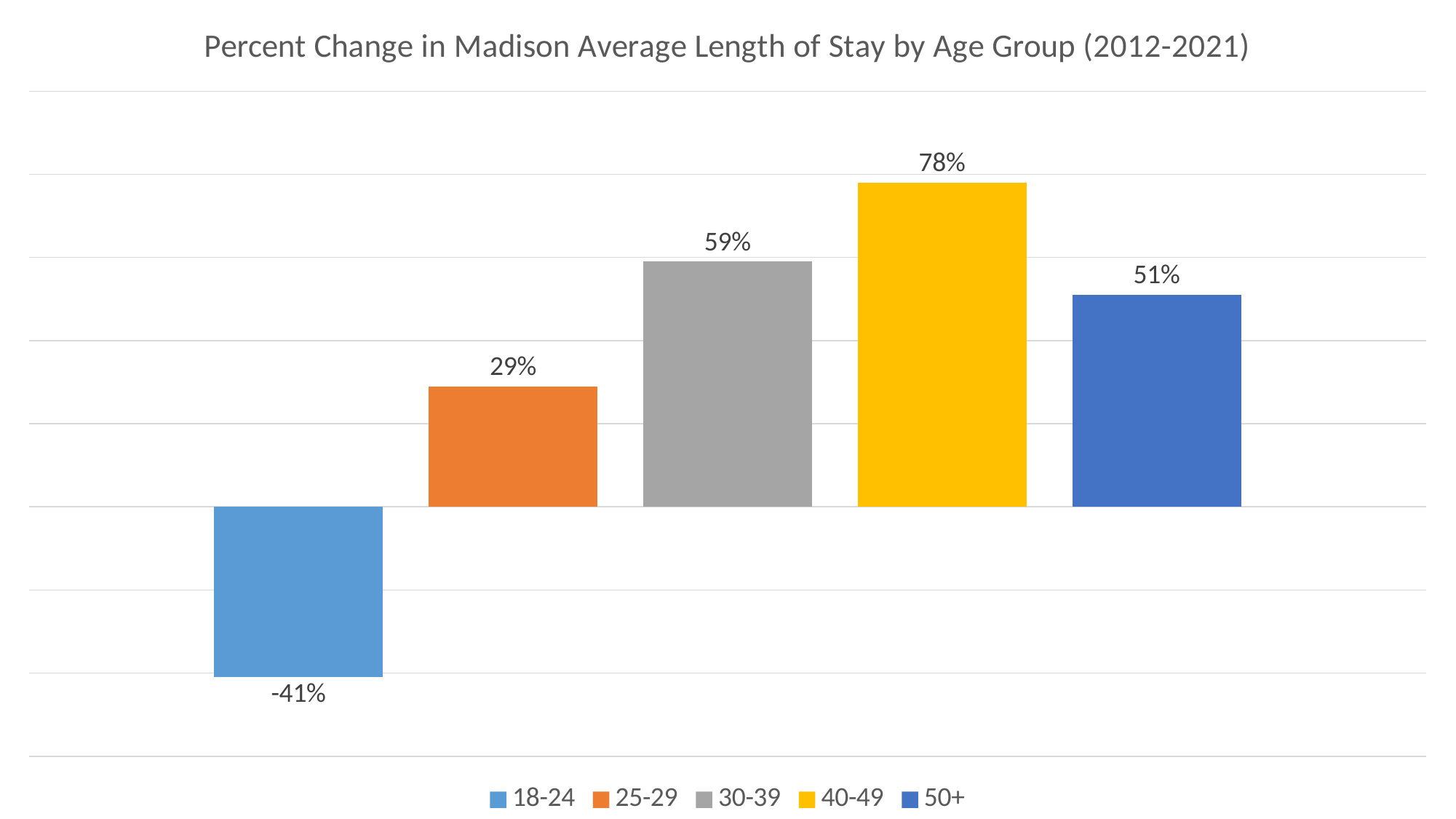
What is the percent change in average length of stay for the 18-24 age group? -41% What is the percent change in average length of stay for the 50+ age group? 51% What type of chart is shown on the slide? Bar chart What is the title of the chart? Percent Change in Madison Average Length of Stay by Age Group (2012-2021) Which age group has the highest percent change in average length of stay? 40-49 Which age group has the lowest percent change in average length of stay? 18-24 How many age groups are shown in the chart? 5 What is the percent change in average length of stay for the 40-49 age group? 78% What is the difference between the percent change for the 50+ group and the 25-29 group? 22% How many entries does the legend list? 5 Which age group has a larger percent change, 30-39 or 50+? 30-39 What is the difference between the percent change for the 40-49 group and the 30-39 group? 19%